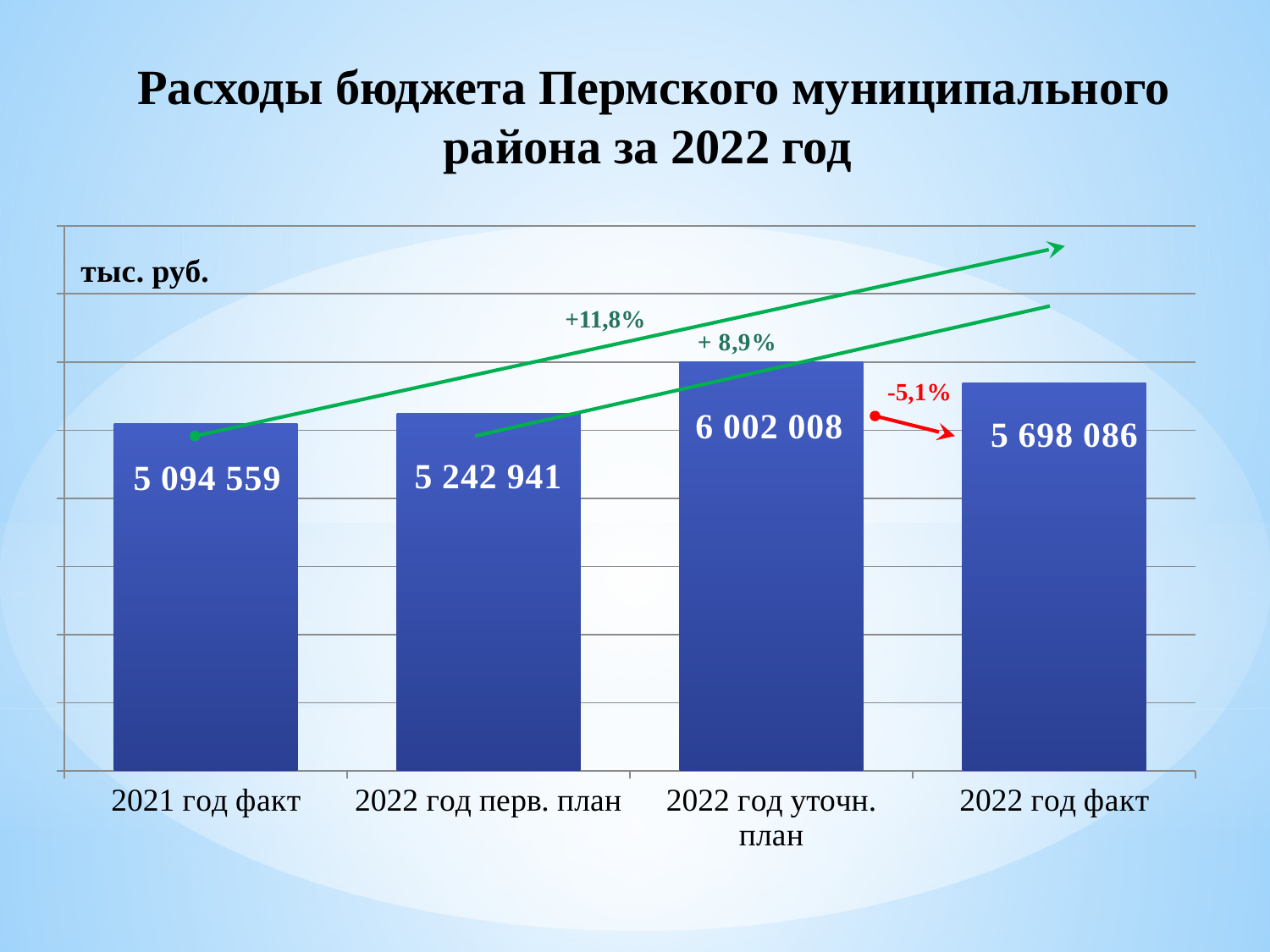
What unit of measurement is indicated on the chart? тыс. руб. What kind of chart is shown on the slide? Bar chart What is the difference between the values for 2022 год перв. план and 2021 год факт? 148 382 What is the value for 2022 год перв. план? 5 242 941 Which is larger, the value for 2022 год факт or the value for 2022 год перв. план? 2022 год факт What is the value for 2021 год факт? 5 094 559 What is the value for 2022 год уточн. план? 6 002 008 Which category has the highest value? 2022 год уточн. план How many categories are shown in the chart? 4 What is the value for 2022 год факт? 5 698 086 Which category has the lowest value? 2021 год факт What is the difference between the values for 2022 год уточн. план and 2022 год факт? 303 922